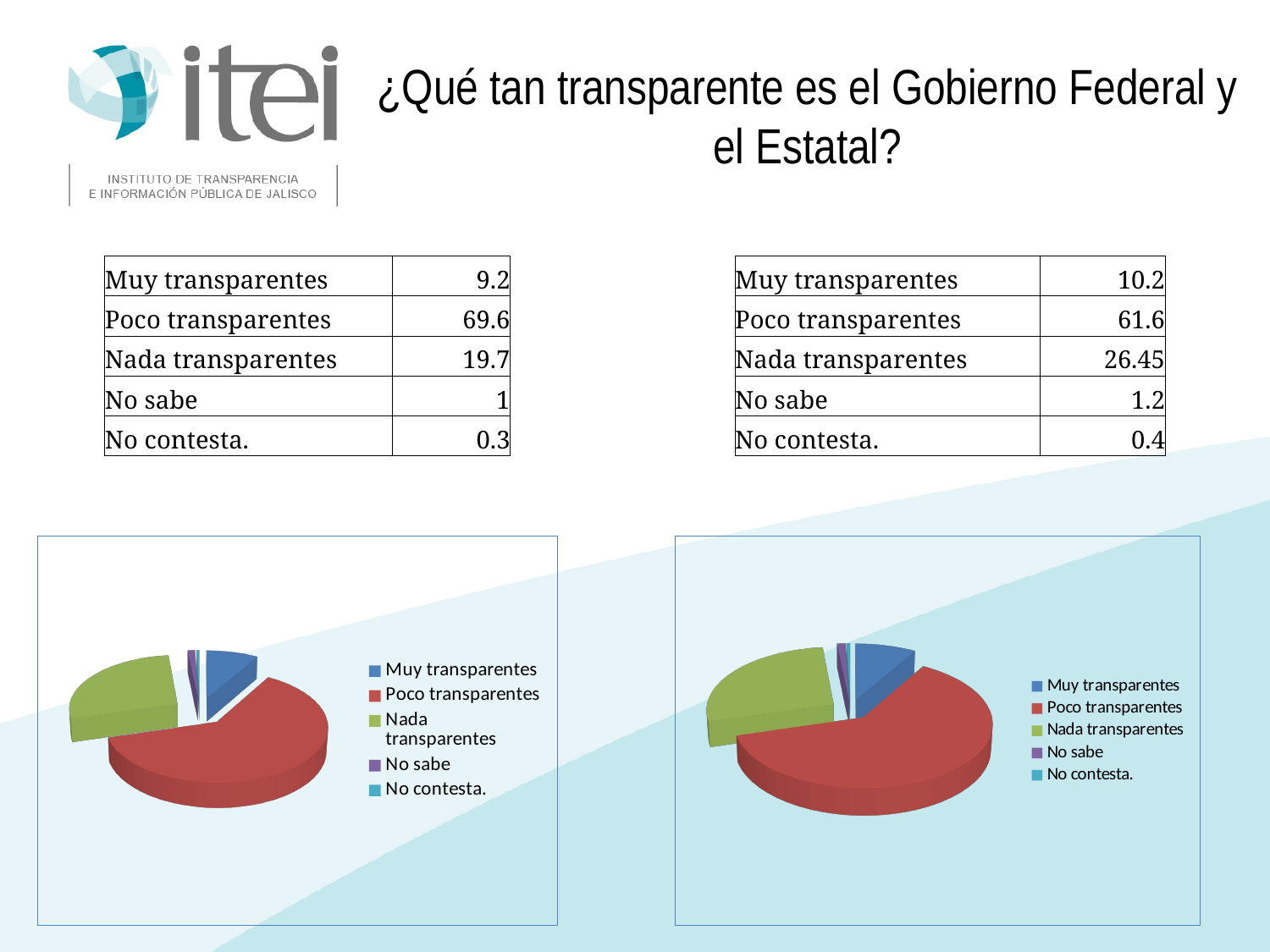
According to the right table, what is the value for Nada transparentes? 26.45 In the left pie chart, which category has the largest slice? Poco transparentes According to the right table, what is the value for No sabe? 1.2 In the right pie chart, which category has the largest slice? Poco transparentes Which is larger: Poco transparentes in the left table or Poco transparentes in the right table? left table (69.6) In the left pie chart, which colour represents Nada transparentes? green According to the left table, what is the value for Muy transparentes? 9.2 In the right pie chart, which category has the smallest slice? No contesta. How many categories does the legend of the left pie chart list? 5 What is the difference between Nada transparentes in the right table (26.45) and in the left table (19.7)? 6.75 What kind of chart is shown on the left side of the slide? pie chart According to the left table, what is the value for Poco transparentes? 69.6